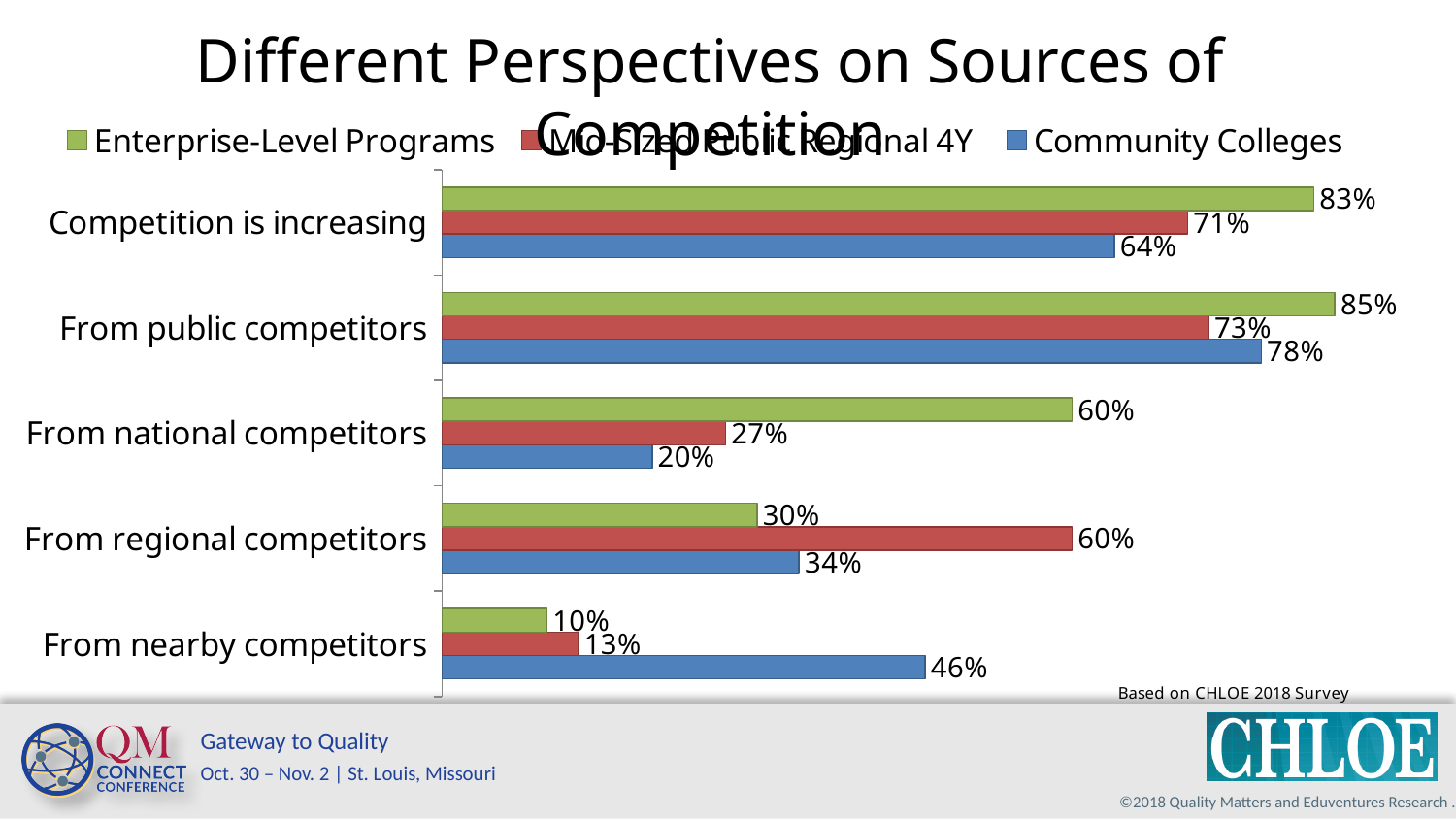
What is the value for Enterprise-Level Programs in the "From national competitors" category? 60% What kind of chart is shown on the slide? Bar chart What is the value for Community Colleges in the "Competition is increasing" category? 64% What is the value of the red (middle) series in the "From regional competitors" category? 60% How many categories are shown on the chart? 5 What is the difference between the Community Colleges values for "From public competitors" and "From nearby competitors"? 32 percentage points For "From regional competitors", which is larger: the Enterprise-Level Programs value or the Community Colleges value? Community Colleges What is the difference between the Enterprise-Level Programs and Community Colleges values for "From national competitors"? 40 percentage points In which category does Enterprise-Level Programs have its highest value? From public competitors How many series does the legend list? 3 In which category does Community Colleges have its lowest value? From national competitors What is the value for Community Colleges in the "From nearby competitors" category? 46%